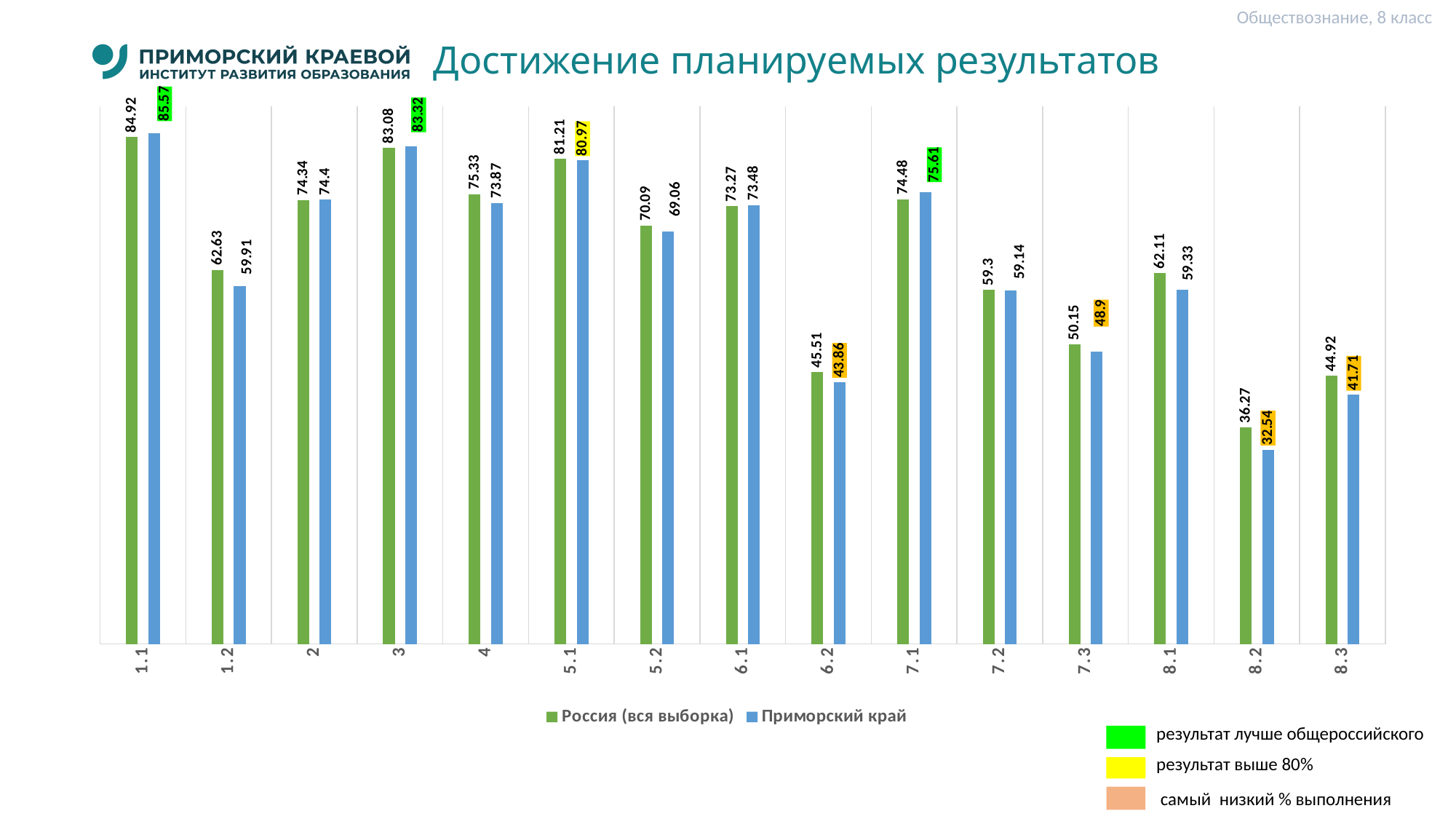
What is the difference between the Россия (вся выборка) and Приморский край values for category 1.2? 2.72 What is the value for Приморский край for category 8.2? 32.54 What is the value for Приморский край for category 1.1? 85.57 What is the value for Россия (вся выборка) for category 6.2? 45.51 What is the title of the chart on the slide? Достижение планируемых результатов For category 7.1, which is larger: the value for Россия (вся выборка) or for Приморский край? Приморский край Which category has the lowest value for Приморский край? 8.2 How many series does the legend list? 2 For category 8.3, which is larger: the value for Россия (вся выборка) or for Приморский край? Россия (вся выборка) How many categories are shown on the x axis? 15 Which category has the highest value for Россия (вся выборка)? 1.1 What kind of chart is shown on the slide? Bar chart